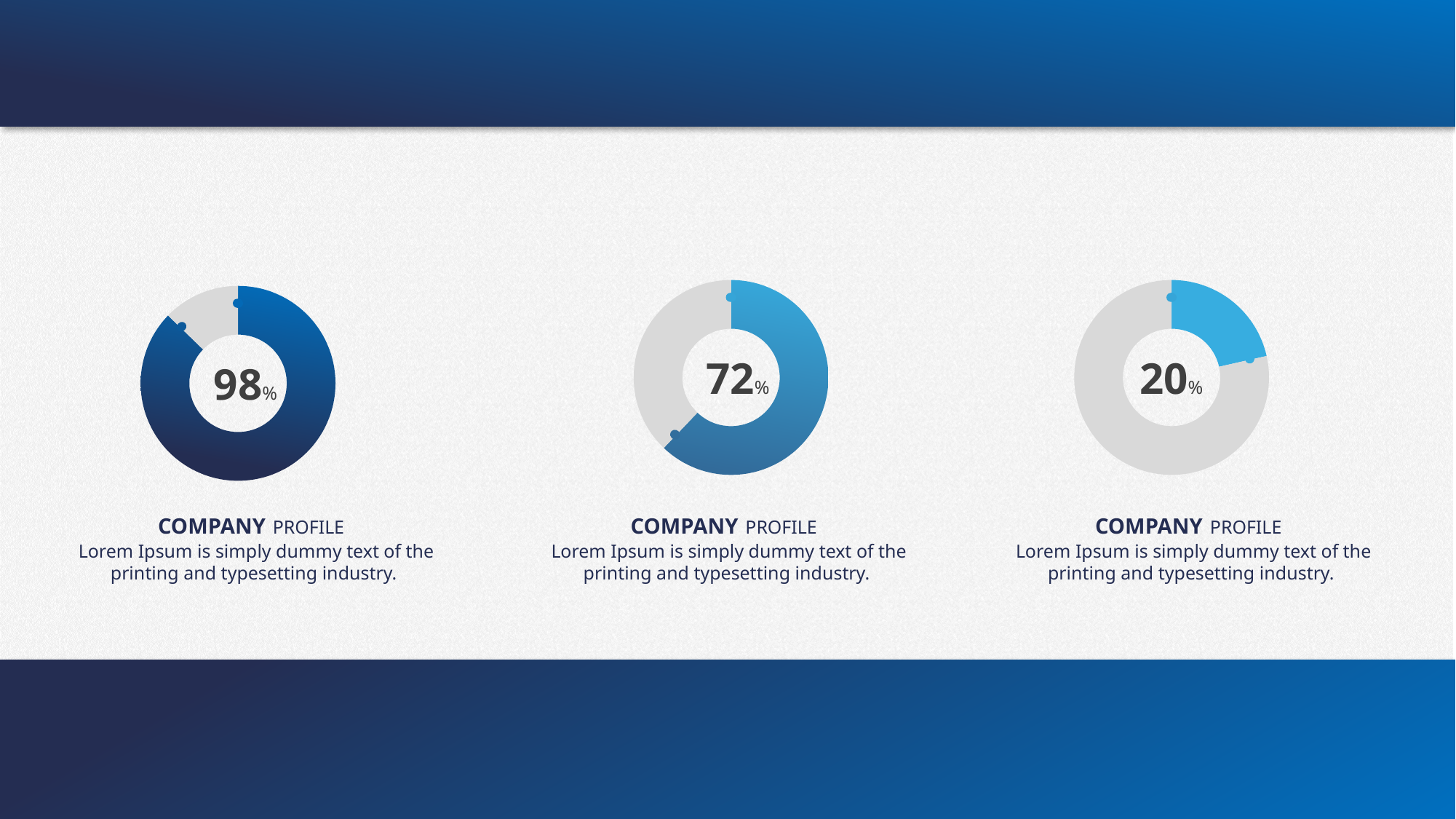
What percentage is shown in the centre of the right donut chart? 20% Which of the three donut charts shows the highest percentage? The left chart (98%) Do the percentages rise or fall moving from the left chart to the right chart? Fall Is the percentage in the middle donut chart larger or smaller than the percentage in the right donut chart? Larger What heading appears below each donut chart? COMPANY PROFILE What percentage is shown in the centre of the left donut chart? 98% Which of the three donut charts shows the lowest percentage? The right chart (20%) What is the difference between the percentage in the left donut chart and the percentage in the middle donut chart? 26% How many donut charts are on the slide? 3 What is the difference between the percentage in the middle donut chart and the percentage in the right donut chart? 52% What kind of chart is used to display the percentages on the slide? Donut chart What percentage is shown in the centre of the middle donut chart? 72%